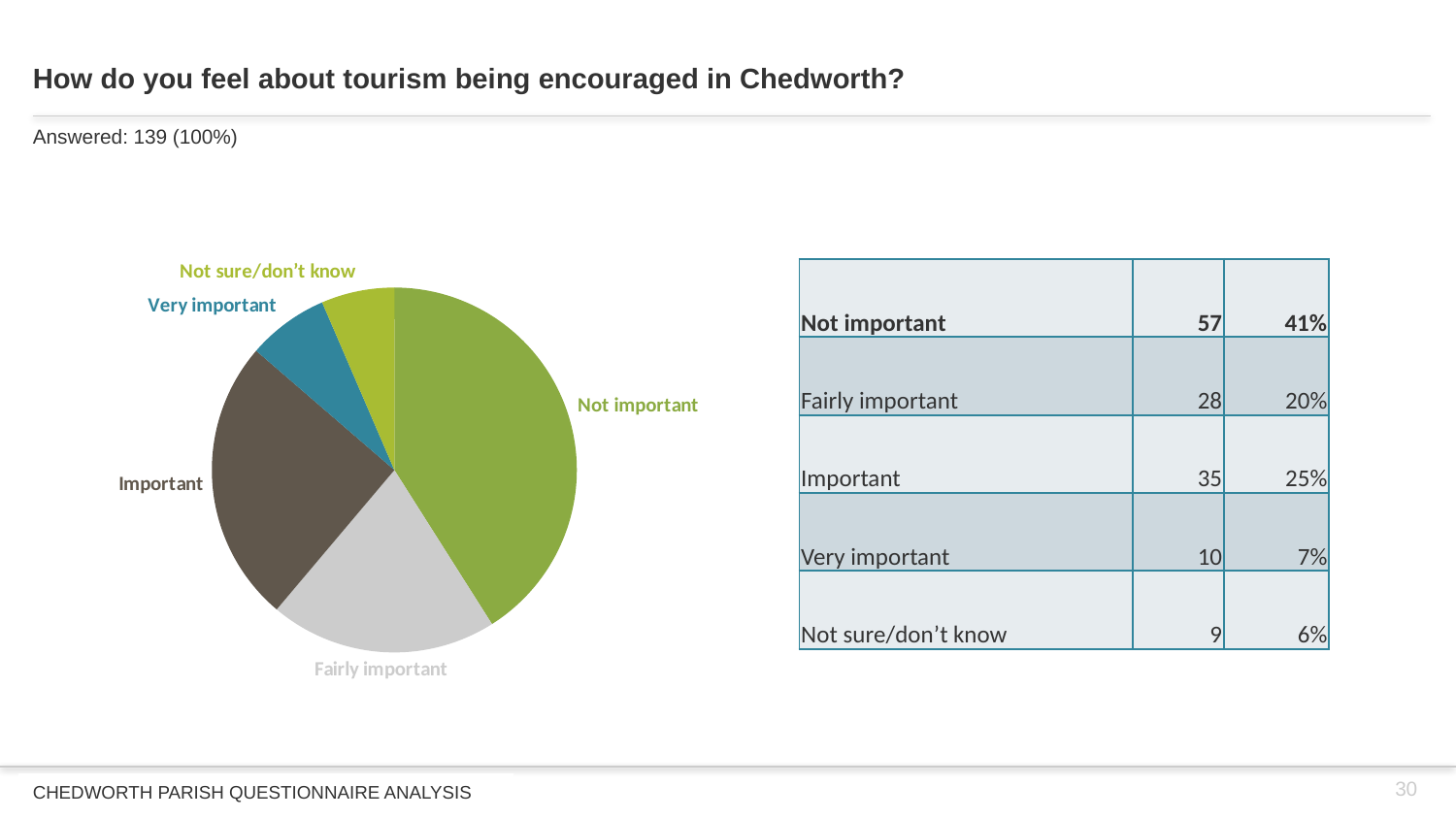
What is the difference in respondent counts between 'Not important' and 'Important', using the table values? 22 According to the table beside the pie chart, how many respondents answered 'Very important'? 10 What share of the pie does the 'Fairly important' slice represent, according to the table? 20% What is the title of the slide containing the pie chart? How do you feel about tourism being encouraged in Chedworth? According to the table beside the pie chart, what percentage of respondents answered 'Important'? 25% How many slices does the pie chart have? 5 Which slice is larger in the pie chart, 'Important' or 'Fairly important'? Important Which category has the largest slice of the pie chart? Not important Which category has the smallest slice of the pie chart? Not sure/don't know How many people answered the question shown on the slide? 139 According to the table beside the pie chart, how many respondents answered 'Not important'? 57 What kind of chart is shown on the slide? pie chart